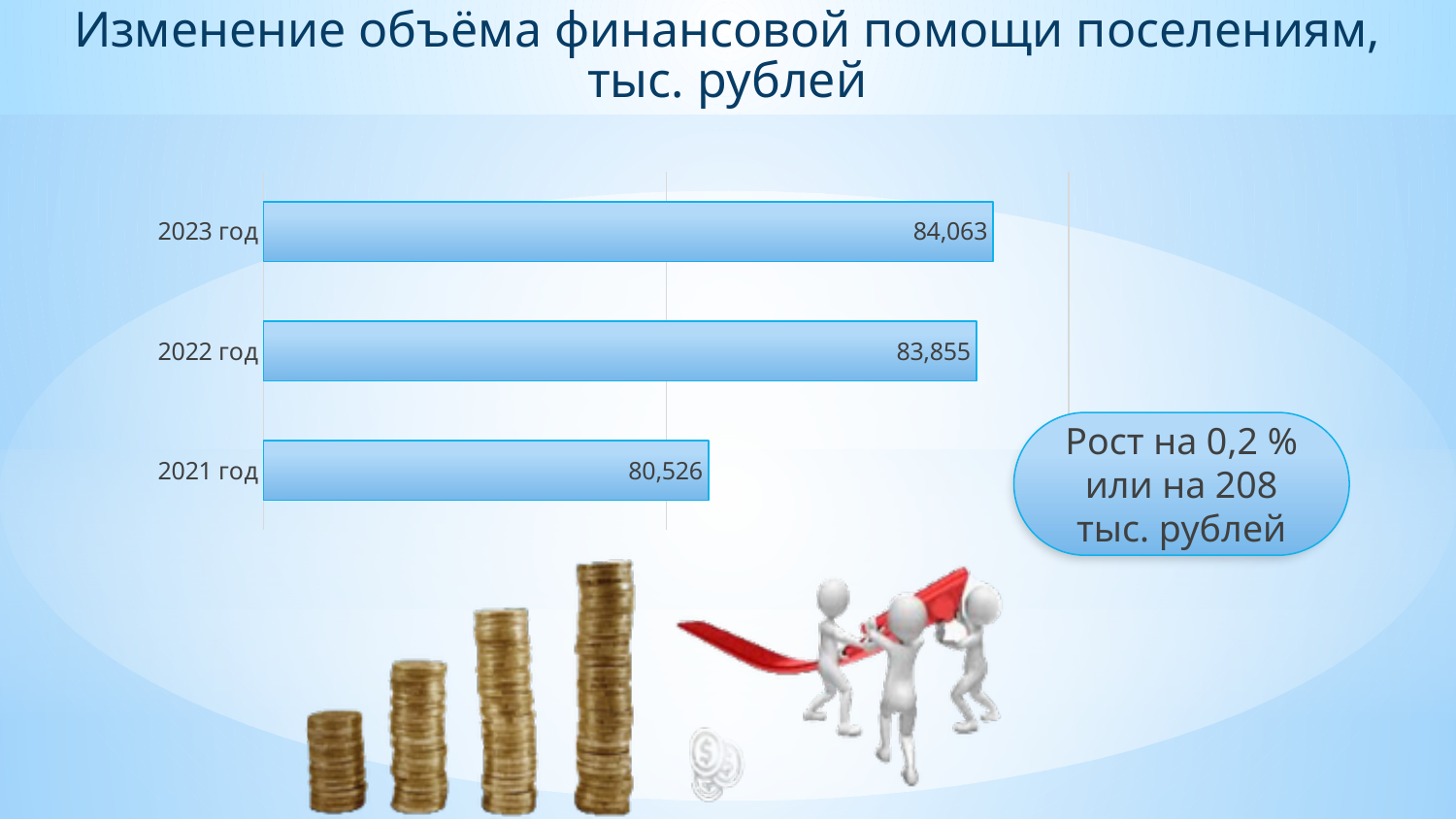
What is the difference between the values for 2023 год and 2021 год? 3,537 Which year has the highest value? 2023 год What is the value for 2023 год? 84,063 What is the difference between the values for 2023 год and 2022 год? 208 How many years are shown in the chart? 3 What kind of chart is shown on the slide? Bar chart What is the value for 2021 год? 80,526 What is the difference between the values for 2022 год and 2021 год? 3,329 What is the value for 2022 год? 83,855 What is the title of the chart? Изменение объёма финансовой помощи поселениям, тыс. рублей Which year has the lowest value? 2021 год Which is larger, the value for 2022 год or the value for 2021 год? 2022 год